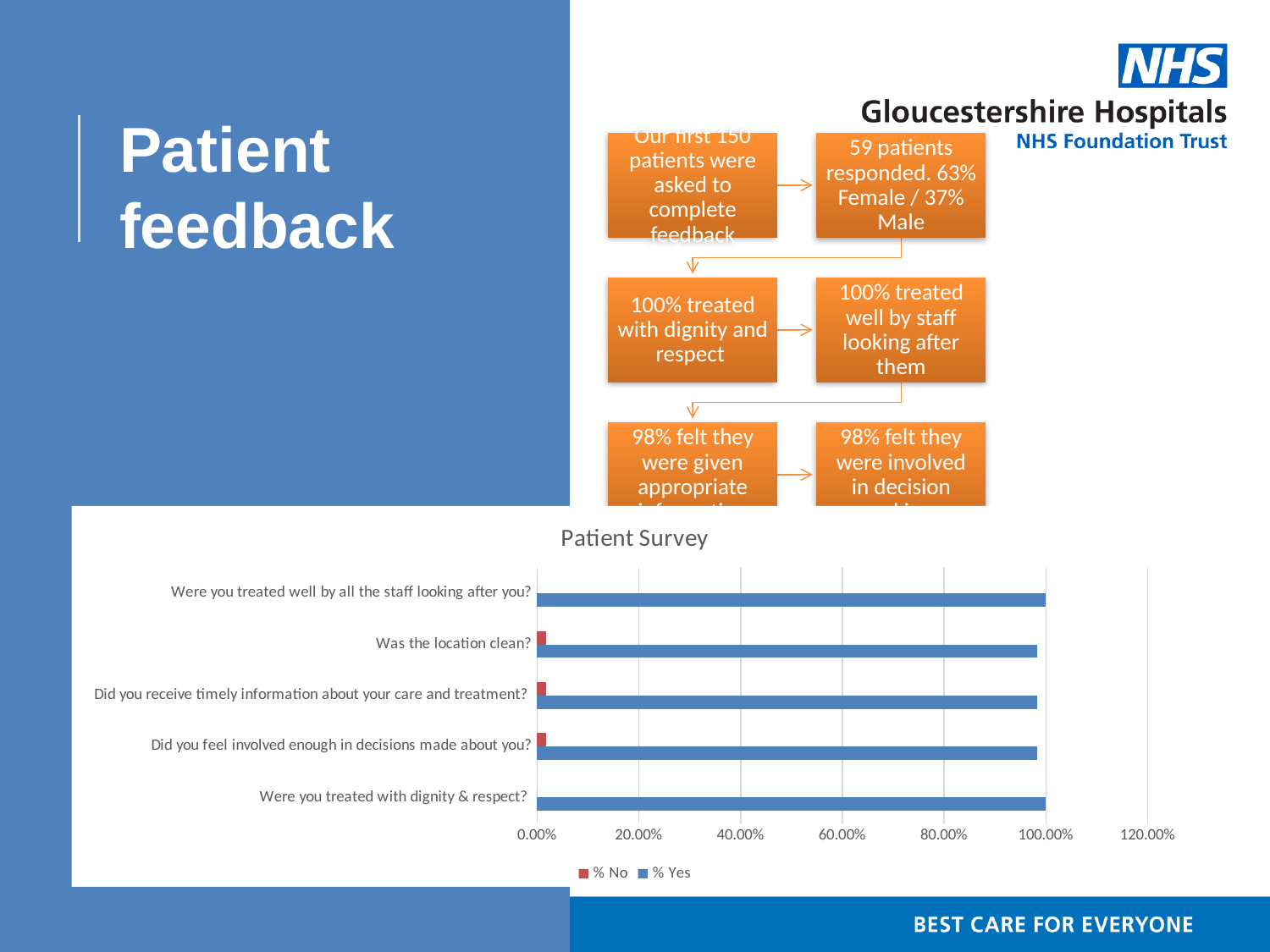
What is the title of the chart at the bottom of the slide? Patient Survey On the Patient Survey chart, is the % Yes value for 'Was the location clean?' greater or less than 80.00%? greater What kind of chart is the Patient Survey chart? bar chart On the Patient Survey chart, is the % No value for 'Did you feel involved enough in decisions made about you?' greater or less than 20.00%? less On the Patient Survey chart, is the % No value for 'Was the location clean?' greater or less than 20.00%? less How many series does the legend of the Patient Survey chart list? 2 On the Patient Survey chart, what is the % Yes value for 'Were you treated well by all the staff looking after you?' 100.00% On the Patient Survey chart, for 'Did you receive timely information about your care and treatment?', which is larger: % Yes or % No? % Yes On the Patient Survey chart, what is the % Yes value for 'Were you treated with dignity & respect?' 100.00% What are the two series named in the legend of the Patient Survey chart? % No and % Yes How many survey questions (categories) are shown on the Patient Survey chart? 5